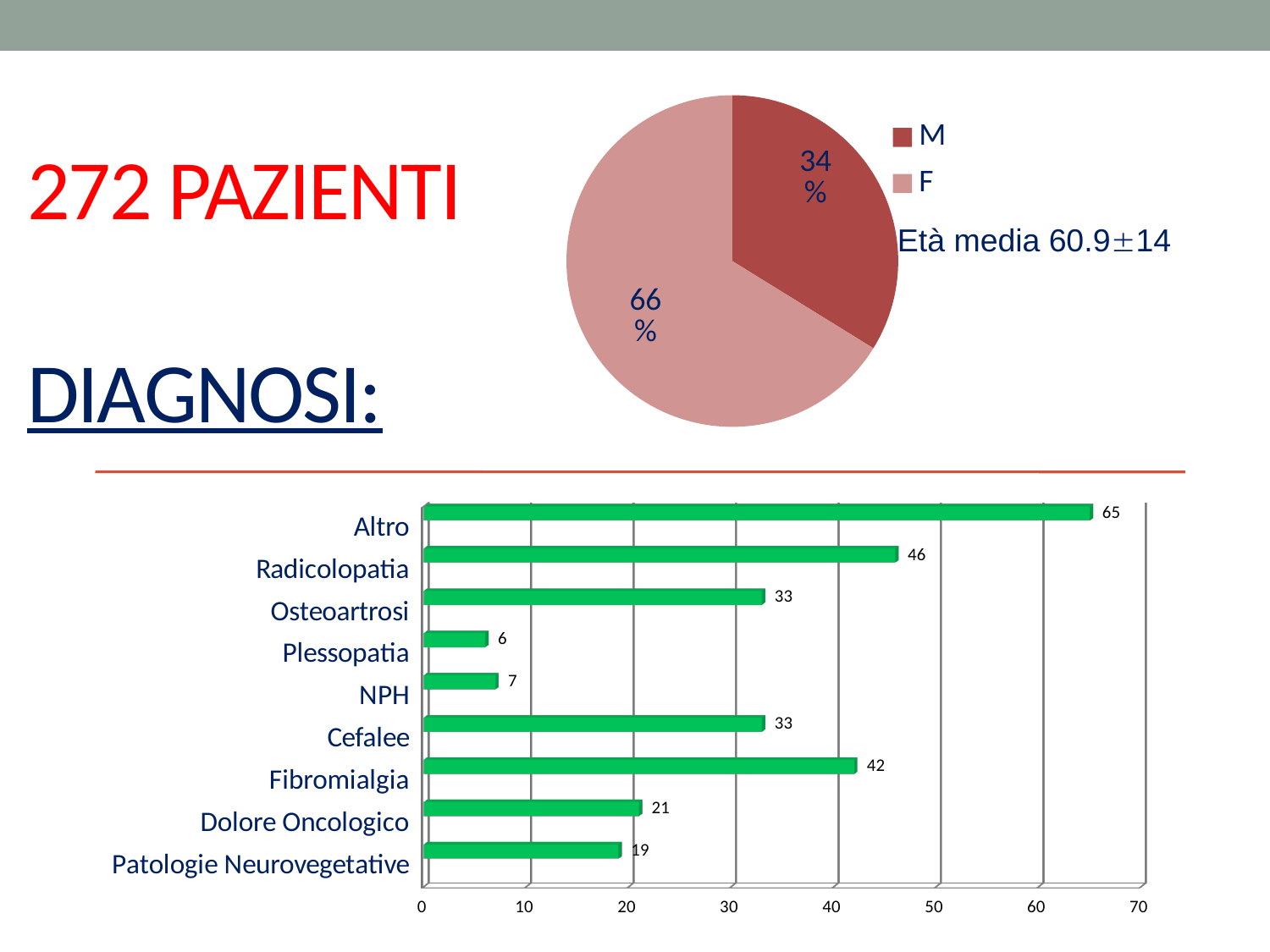
In the pie chart, what share of patients is M? 34% In the pie chart, what share of patients is F? 66% How many entries does the legend of the pie chart list? 2 How many categories are shown in the bar chart? 9 In the bar chart, what is the value for Fibromialgia? 42 In the bar chart, which is larger, Dolore Oncologico or Patologie Neurovegetative? Dolore Oncologico In the bar chart, which category has the lowest value? Plessopatia In the bar chart, what is the value for Radicolopatia? 46 In the bar chart, what is the difference between Altro and Radicolopatia? 19 In the bar chart, what is the value for NPH? 7 In the bar chart, which category has the highest value? Altro What kind of chart is the lower chart on the slide? Bar chart